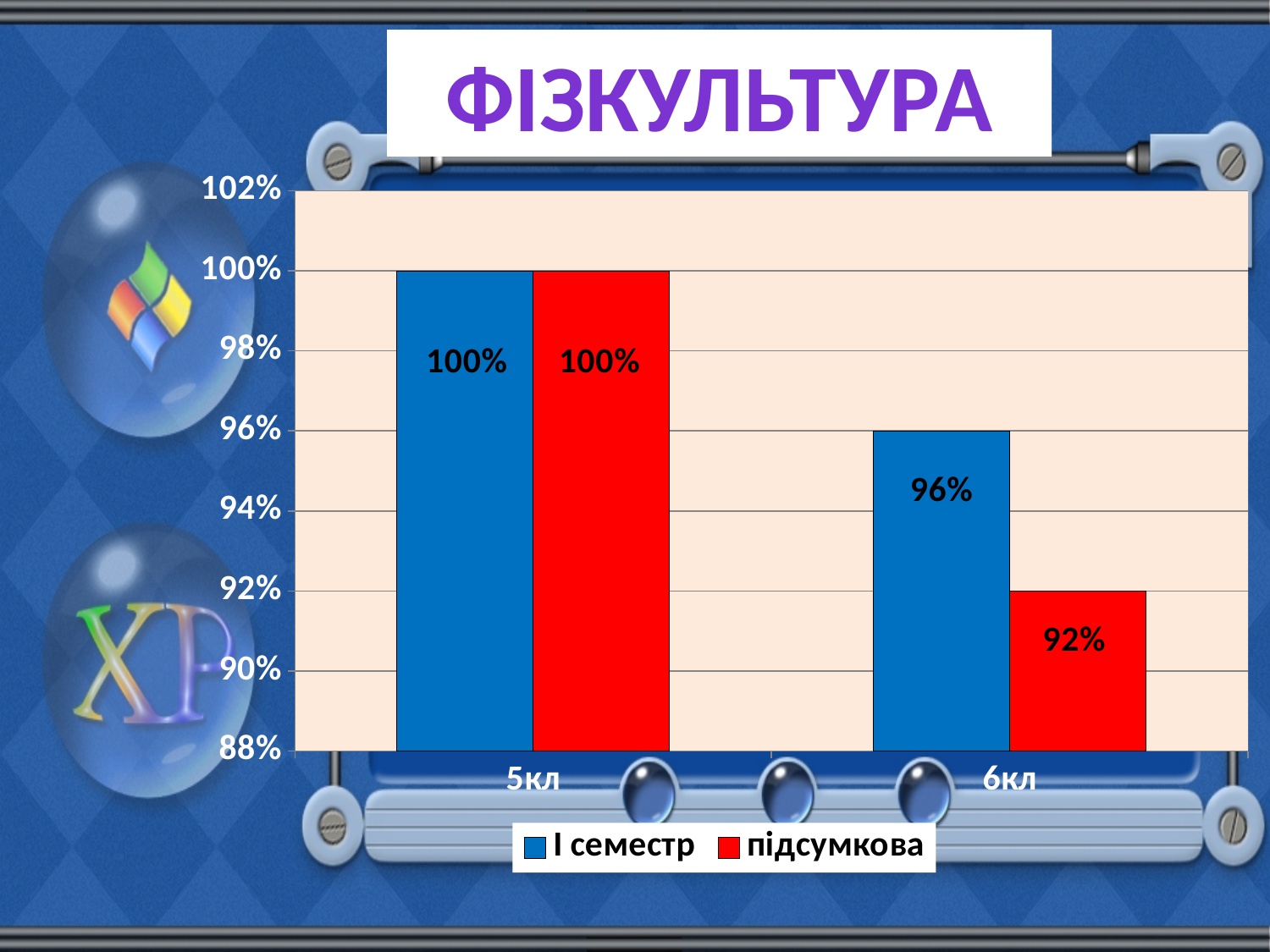
What kind of chart is shown on the slide? bar chart What is the value for 5кл in the І семестр series? 100% How many series does the legend list? 2 Which is larger for 6кл: the І семестр value or the підсумкова value? І семестр What is the value for 5кл in the підсумкова series? 100% Which category has the lowest value in the підсумкова series? 6кл How many categories are shown on the x axis? 2 What is the value for 6кл in the підсумкова series? 92% What is the difference between the І семестр and підсумкова values for 6кл? 4% Is the підсумкова value for 6кл greater or less than 94%? less What is the value for 6кл in the І семестр series? 96% What is the title of the chart? ФІЗКУЛЬТУРА